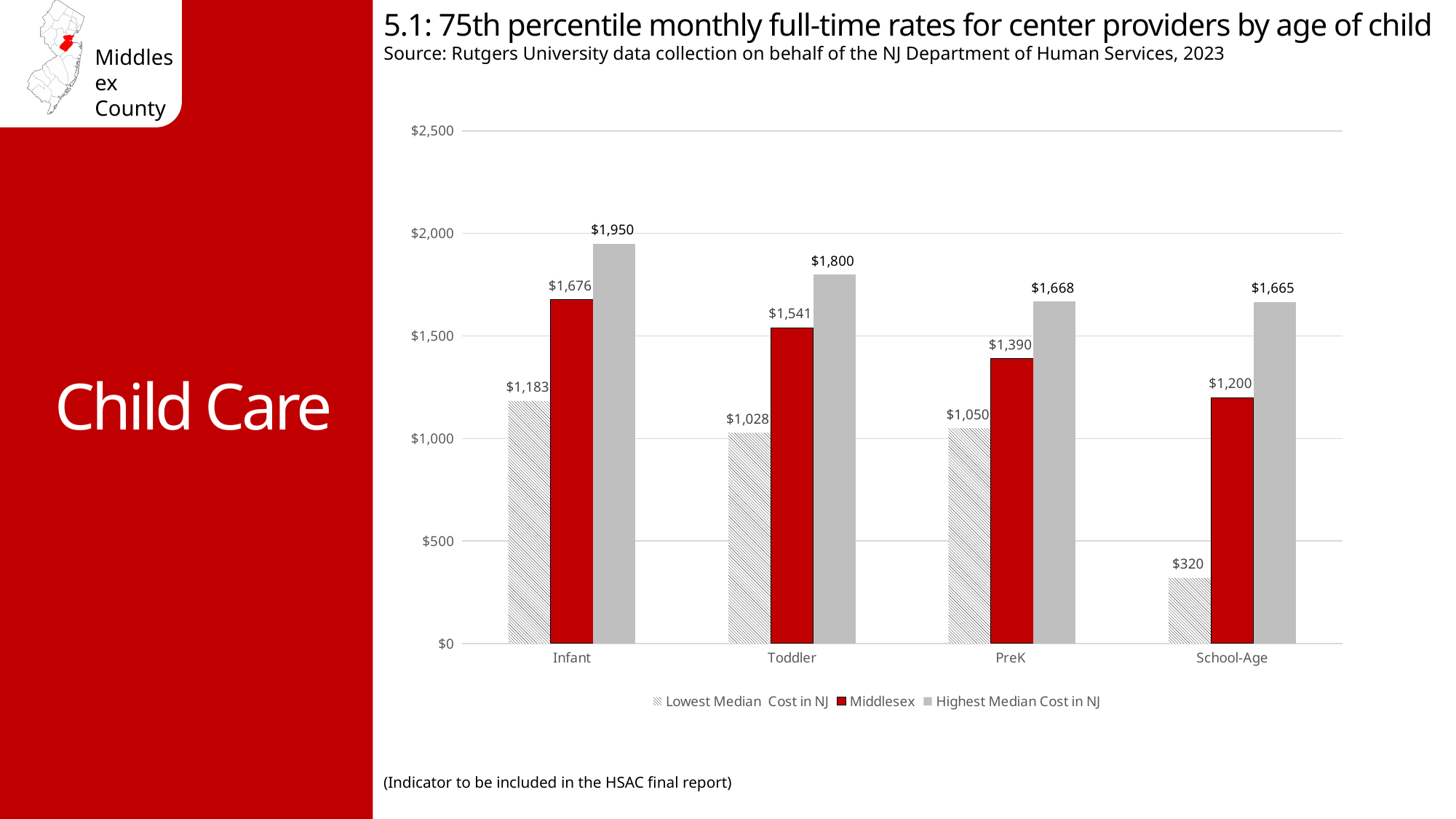
What kind of chart is shown on the slide? bar chart Which is larger: the Middlesex value for Toddler or the Middlesex value for PreK? Toddler What is the Lowest Median Cost in NJ for School-Age? $320 What is the difference between the Highest Median Cost in NJ and the Middlesex value for PreK? $278 How many age categories are shown on the x axis? 4 How many series does the legend list? 3 Which age category has the lowest Lowest Median Cost in NJ value? School-Age What is the Highest Median Cost in NJ for Toddler? $1,800 What is the Middlesex value for Infant? $1,676 Which age category has the highest Middlesex value? Infant Do the Middlesex values rise or fall from Infant to School-Age? fall Is the Middlesex value for School-Age greater or less than $1,500? less